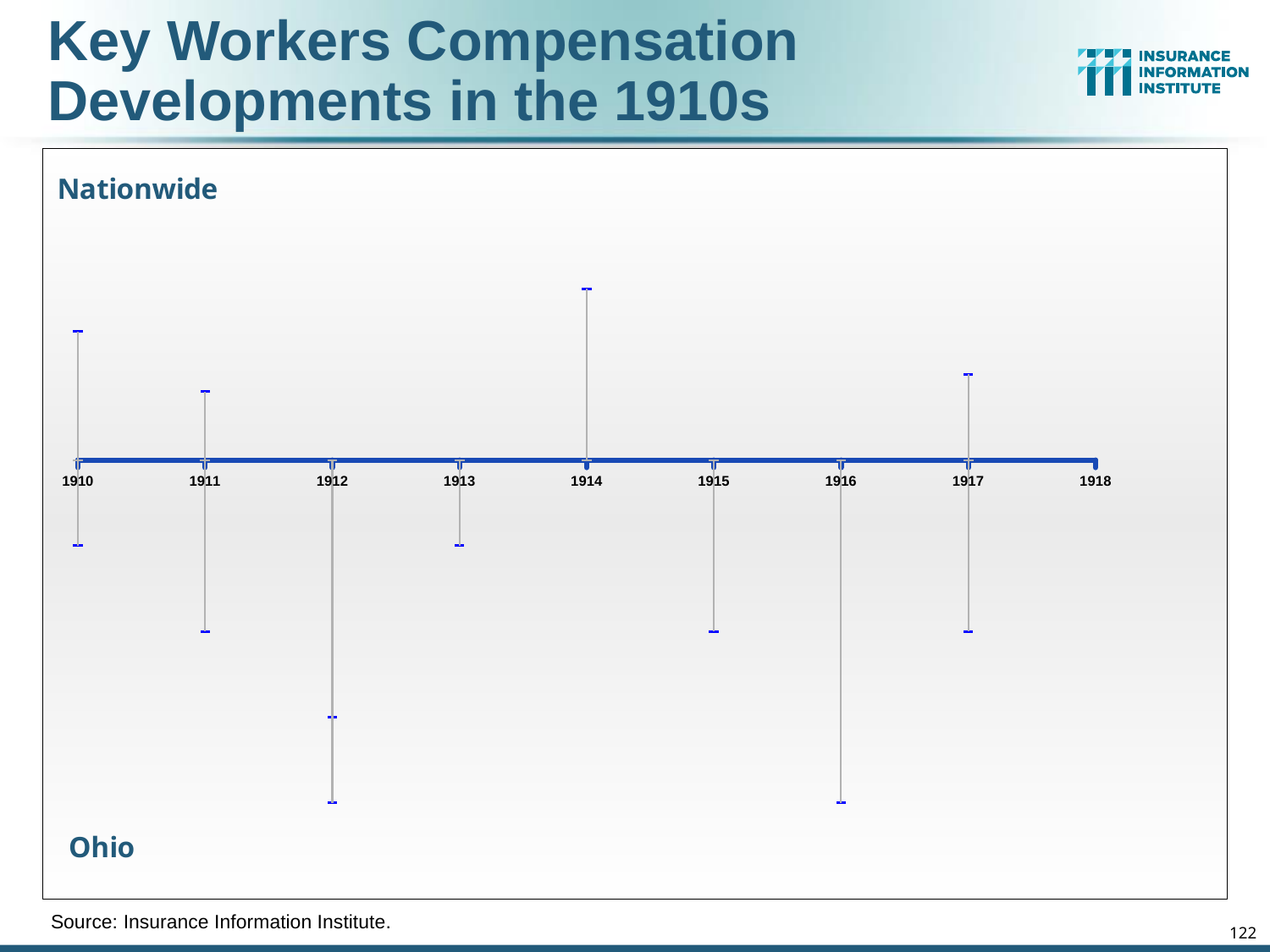
How many years are labelled along the timeline axis? 9 Which year has the tallest marker above the timeline axis? 1914 Which label appears above the timeline and which appears below it? Nationwide above, Ohio below What is the title of the slide containing the timeline? Key Workers Compensation Developments in the 1910s Which years on the timeline have a marker above the axis line (Nationwide side)? 1910, 1911, 1914, 1917 What is the first year shown on the timeline axis? 1910 What is the last year shown on the timeline axis? 1918 What kind of chart is shown on the slide? Timeline Does the year 1918 have any event marker above or below the axis line? No